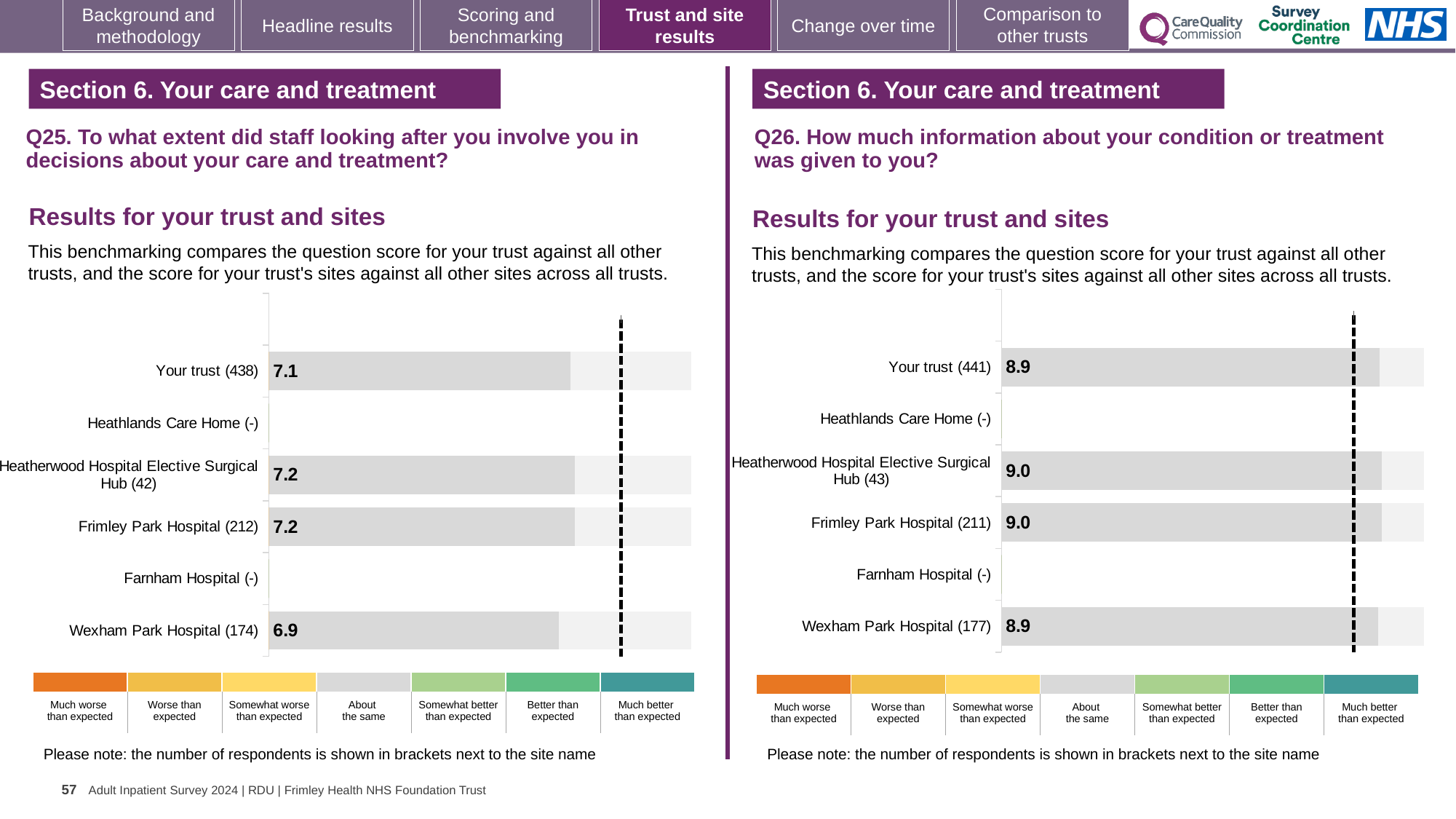
On the Q25 chart (left), how many categories does the colour legend below the chart list? 7 On the Q25 chart (left), which is larger: the score for Heatherwood Hospital Elective Surgical Hub (42) or the score for Your trust (438)? Heatherwood Hospital Elective Surgical Hub (42) On the Q25 chart (left), what is the score for Your trust (438)? 7.1 On the Q25 chart (left), how many sites have a score value printed? 4 On the Q26 chart (right), what is the difference between the scores for Heatherwood Hospital Elective Surgical Hub (43) and Wexham Park Hospital (177)? 0.1 On the Q26 chart (right), what is the score for Frimley Park Hospital (211)? 9.0 What kind of chart is used on the Q26 chart (right)? Bar chart On the Q26 chart (right), what is the score for Your trust (441)? 8.9 On the Q25 chart (left), what is the difference between the scores for Frimley Park Hospital (212) and Wexham Park Hospital (174)? 0.3 On the Q25 chart (left), what is the score for Wexham Park Hospital (174)? 6.9 On the Q25 chart (left), which site has the lowest score shown? Wexham Park Hospital (174) On the Q26 chart (right), how many site rows are listed on the vertical axis? 6